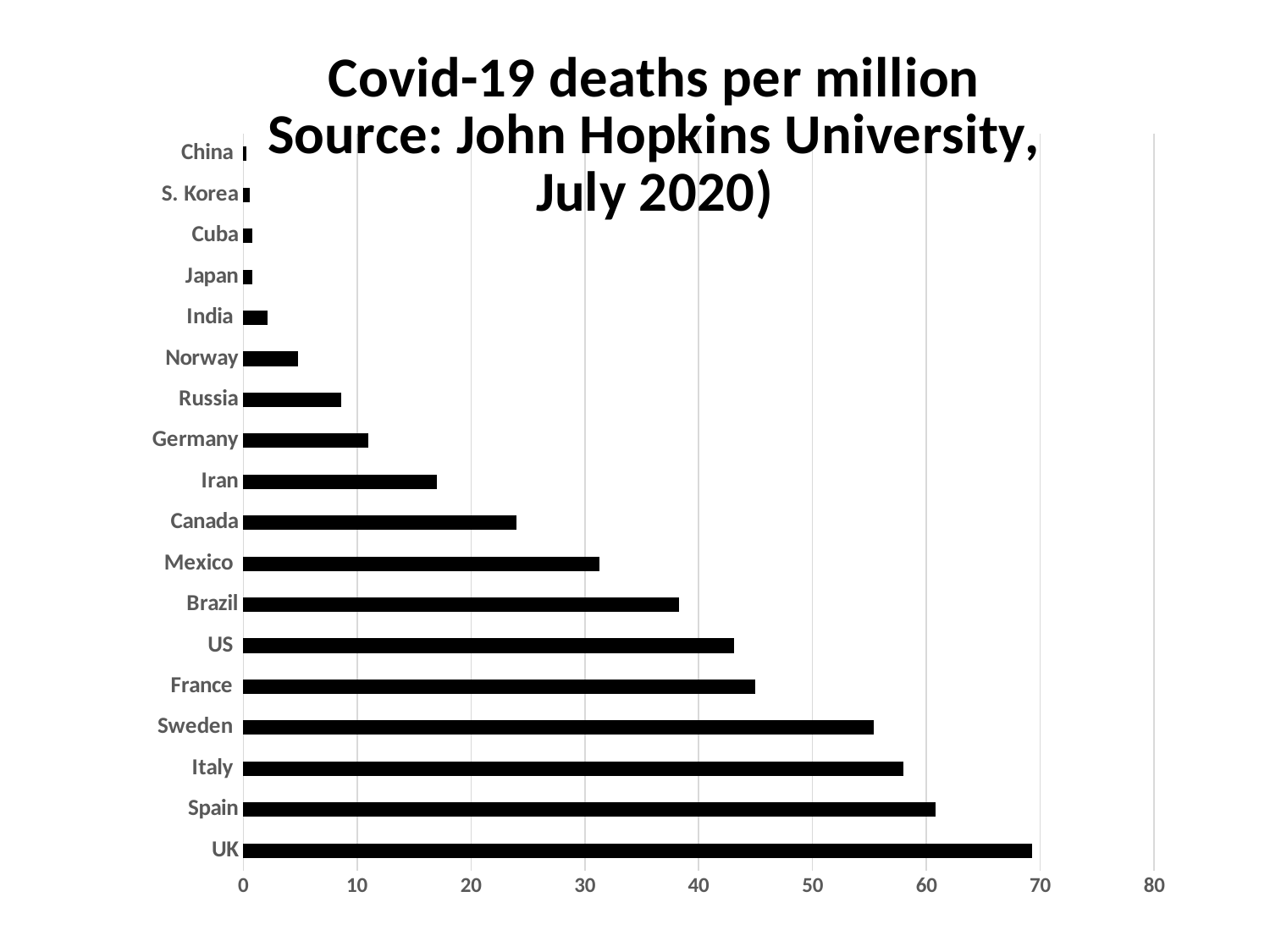
Which country has the highest Covid-19 deaths per million in the chart? UK Is the value for Iran greater or less than 20? less Is the value for Sweden greater or less than 50? greater Which has a higher value, Canada or Iran? Canada Is the value for Brazil greater or less than 40? less Which has a higher value, Sweden or France? Sweden What is the source of the data given in the chart title? John Hopkins University, July 2020 How many countries are shown in the chart? 18 What kind of chart is shown on the slide? Bar chart Which country has the lowest Covid-19 deaths per million in the chart? China